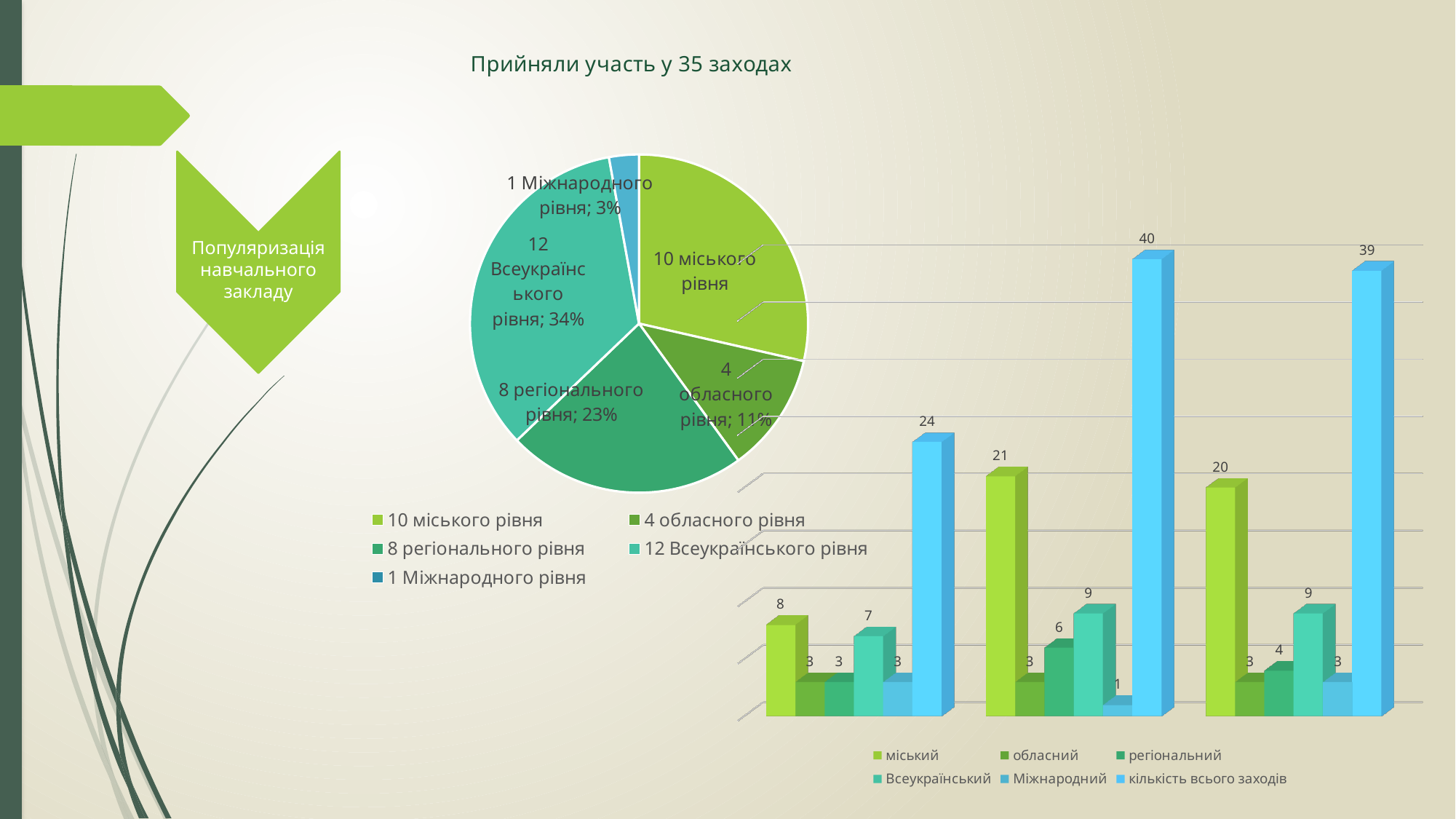
In the pie chart 'Прийняли участь у 35 заходах', what share does '8 регіонального рівня' have? 23% In the bar chart on the right of the slide, what is the difference between 'кількість всього заходів' in the middle group and in the leftmost group? 16 In the bar chart on the right of the slide, what is the value of 'міський' in the middle group? 21 What kind of chart is the chart on the right of the slide? bar chart In the pie chart 'Прийняли участь у 35 заходах', what share does '12 Всеукраїнського рівня' have? 34% How many slices does the pie chart 'Прийняли участь у 35 заходах' have? 5 In the pie chart 'Прийняли участь у 35 заходах', which slice is the largest? 12 Всеукраїнського рівня How many series does the legend of the bar chart on the right of the slide list? 6 In the pie chart 'Прийняли участь у 35 заходах', which slice is the smallest? 1 Міжнародного рівня In the pie chart 'Прийняли участь у 35 заходах', what share does '1 Міжнародного рівня' have? 3% What kind of chart is the chart titled 'Прийняли участь у 35 заходах'? pie chart In the bar chart on the right of the slide, what is the value of 'кількість всього заходів' in the middle group? 40